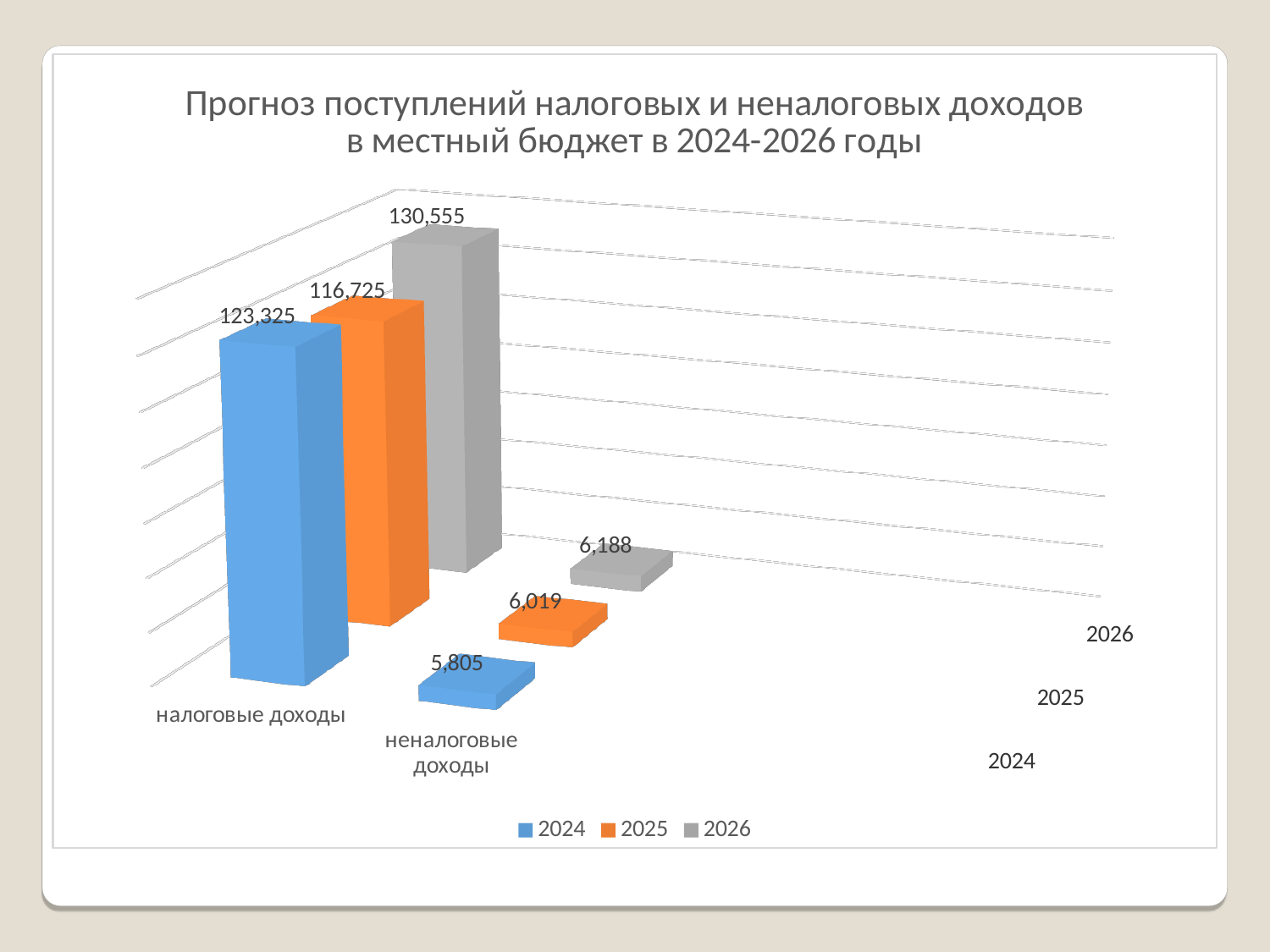
What is the value for налоговые доходы in 2026? 130,555 Which is larger for налоговые доходы: the 2024 value or the 2025 value? 2024 Which year has the highest value for налоговые доходы? 2026 Which year has the lowest value for налоговые доходы? 2025 What is the value for налоговые доходы in 2024? 123,325 What kind of chart is shown on the slide? Bar chart Which year has the lowest value for неналоговые доходы? 2024 What is the value for неналоговые доходы in 2026? 6,188 What is the value for неналоговые доходы in 2025? 6,019 How many series does the legend list? 3 What is the difference between the 2026 and 2024 values for неналоговые доходы? 383 What is the difference between the 2026 and 2024 values for налоговые доходы? 7,230